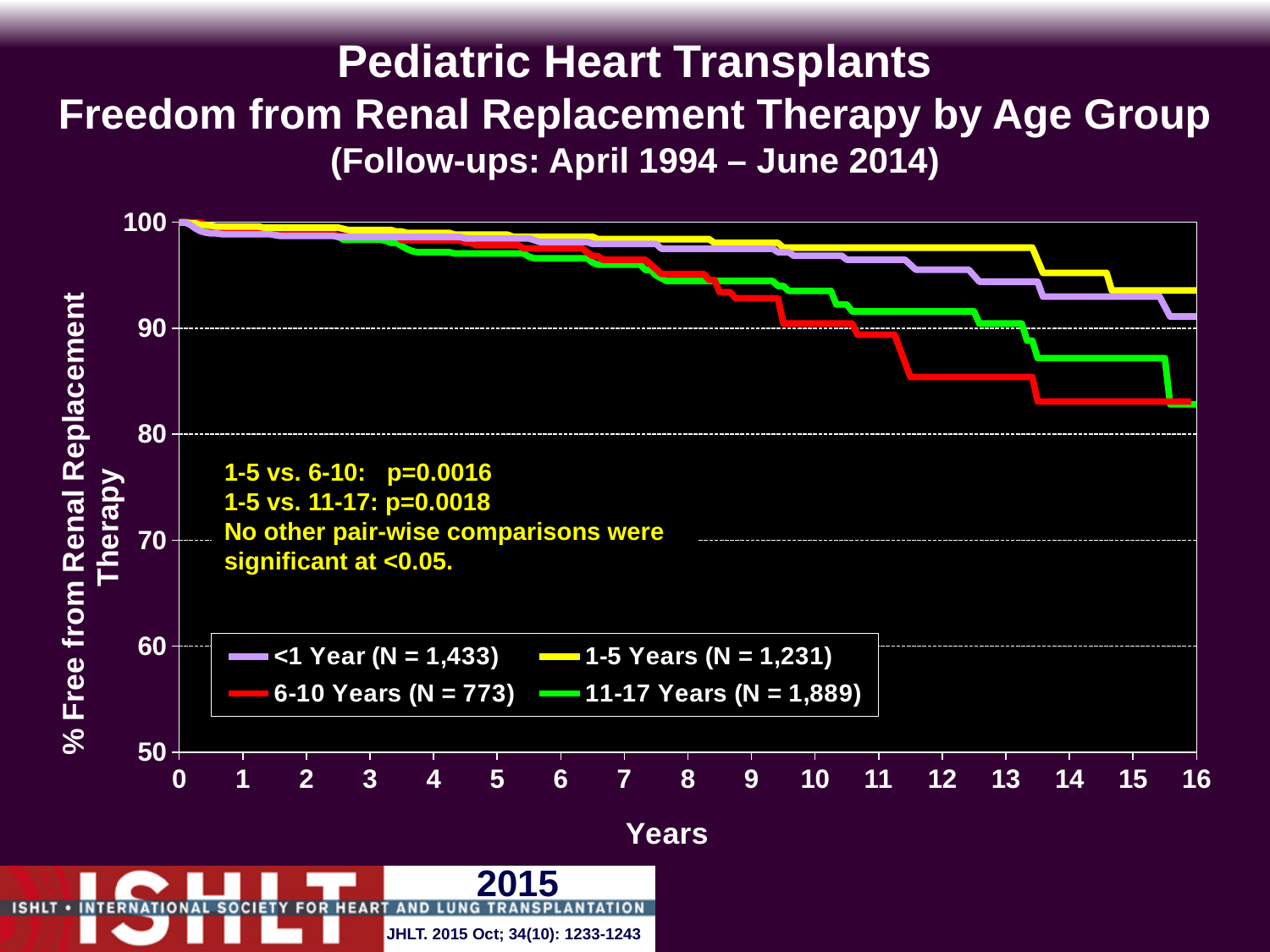
Do the values for the 6-10 Years group rise or fall as the years increase? Fall Which age group has the highest % free from renal replacement therapy at year 16? 1-5 Years What kind of chart is shown on the slide? Line chart What follow-up period is stated in the chart title? April 1994 – June 2014 At year 15, is the value for the 11-17 Years group greater or less than 90? less What is the p-value shown for the comparison of 1-5 vs. 11-17 years? p=0.0018 What is the N for the 6-10 Years group shown in the legend? 773 Which age group has the lowest % free from renal replacement therapy at year 12? 6-10 Years At year 16, is the value for the 6-10 Years group greater or less than 90? less How many series does the legend list? 4 At year 16, is the value for the 1-5 Years group greater or less than 90? greater At year 16, which is larger: the value for the 1-5 Years group or the 6-10 Years group? 1-5 Years